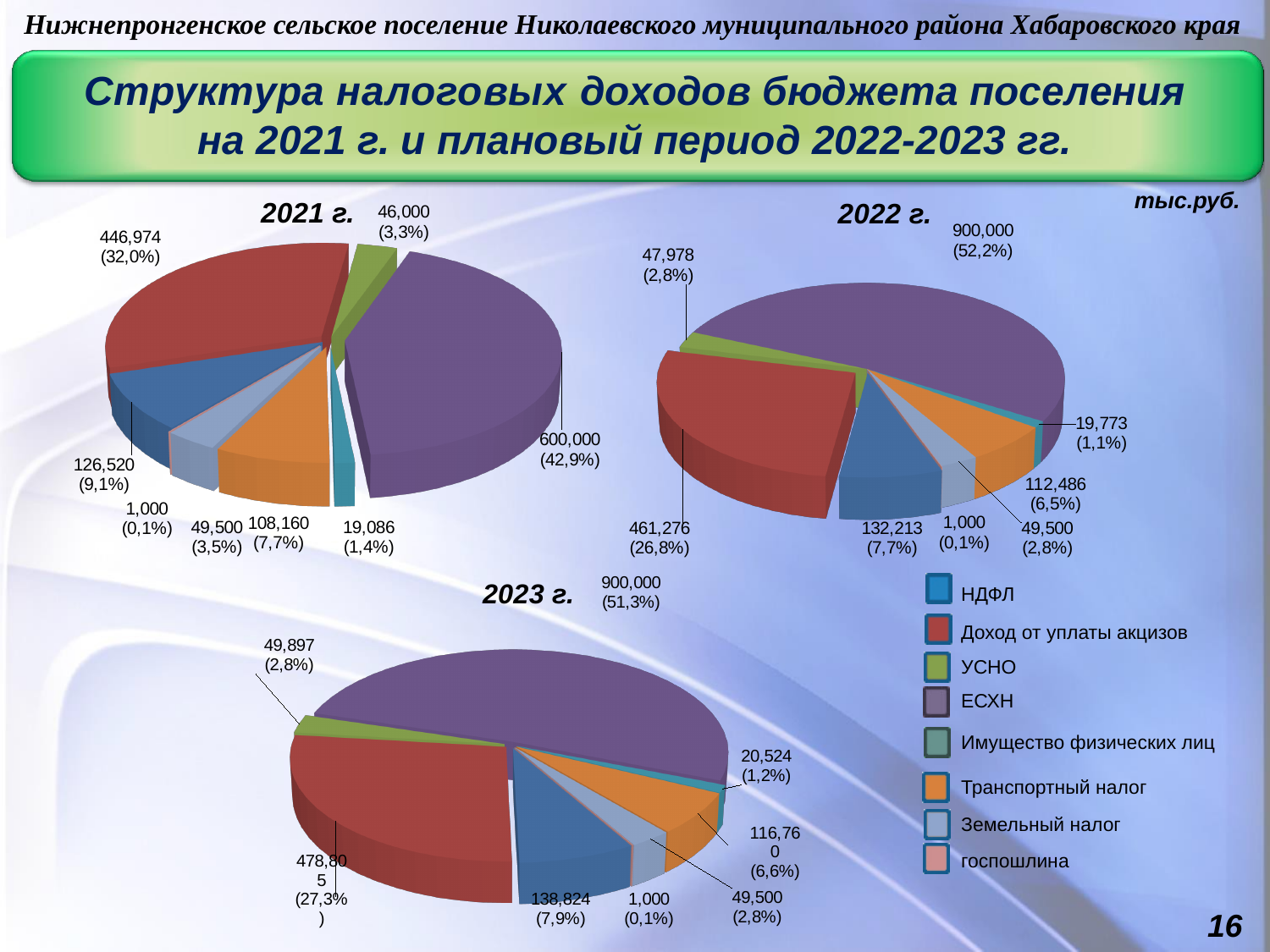
In what units are the values on the slide given? тыс.руб. In the 2023 г. pie chart, what share of the pie does the 900,000 slice represent? 51,3% What is the difference between the 600,000 slice and the 446,974 slice in the 2021 г. pie chart? 153,026 What kind of charts are shown on the slide? Pie charts In the 2022 г. pie chart, what share of the pie does the 900,000 slice represent? 52,2% Which is larger: the 132,213 slice in the 2022 г. chart or the 138,824 slice in the 2023 г. chart? 138,824 (2023 г.) In the 2021 г. pie chart, what is the value of the smallest slice? 1,000 In the 2023 г. pie chart, what is the value of the slice labelled 7,9%? 138,824 In the 2021 г. pie chart, what is the value of the largest slice? 600,000 In the 2022 г. pie chart, what is the value of the slice labelled 26,8%? 461,276 How many entries does the legend list? 8 In the 2021 г. pie chart, what share of the pie does the 446,974 slice represent? 32,0%